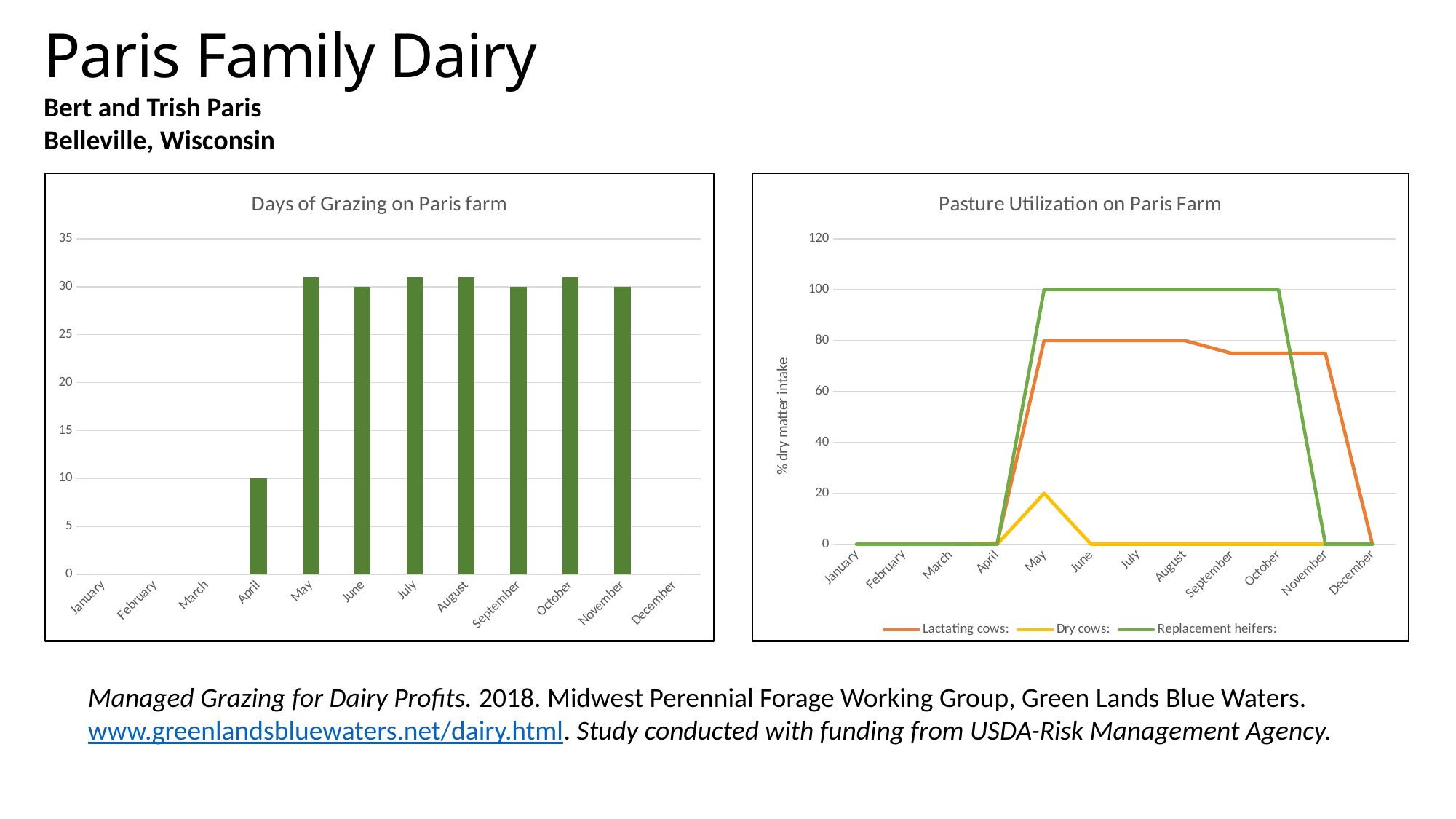
How many series does the legend of the "Pasture Utilization on Paris Farm" chart list? 3 What kind of chart is "Days of Grazing on Paris farm"? bar chart In the "Pasture Utilization on Paris Farm" chart, what is the value for Replacement heifers in July? 100 How many months are shown on the x axis of the "Days of Grazing on Paris farm" chart? 12 In the "Days of Grazing on Paris farm" chart, what is the value for June? 30 In the "Days of Grazing on Paris farm" chart, what is the difference between the values for June and April? 20 In the "Days of Grazing on Paris farm" chart, which is larger, April or September? September In the "Days of Grazing on Paris farm" chart, what is the value for April? 10 What kind of chart is "Pasture Utilization on Paris Farm"? line chart In the "Days of Grazing on Paris farm" chart, is the value for May greater or less than 25? greater In the "Pasture Utilization on Paris Farm" chart, what is the value for Dry cows in May? 20 In the "Pasture Utilization on Paris Farm" chart, what is the label on the y axis? % dry matter intake